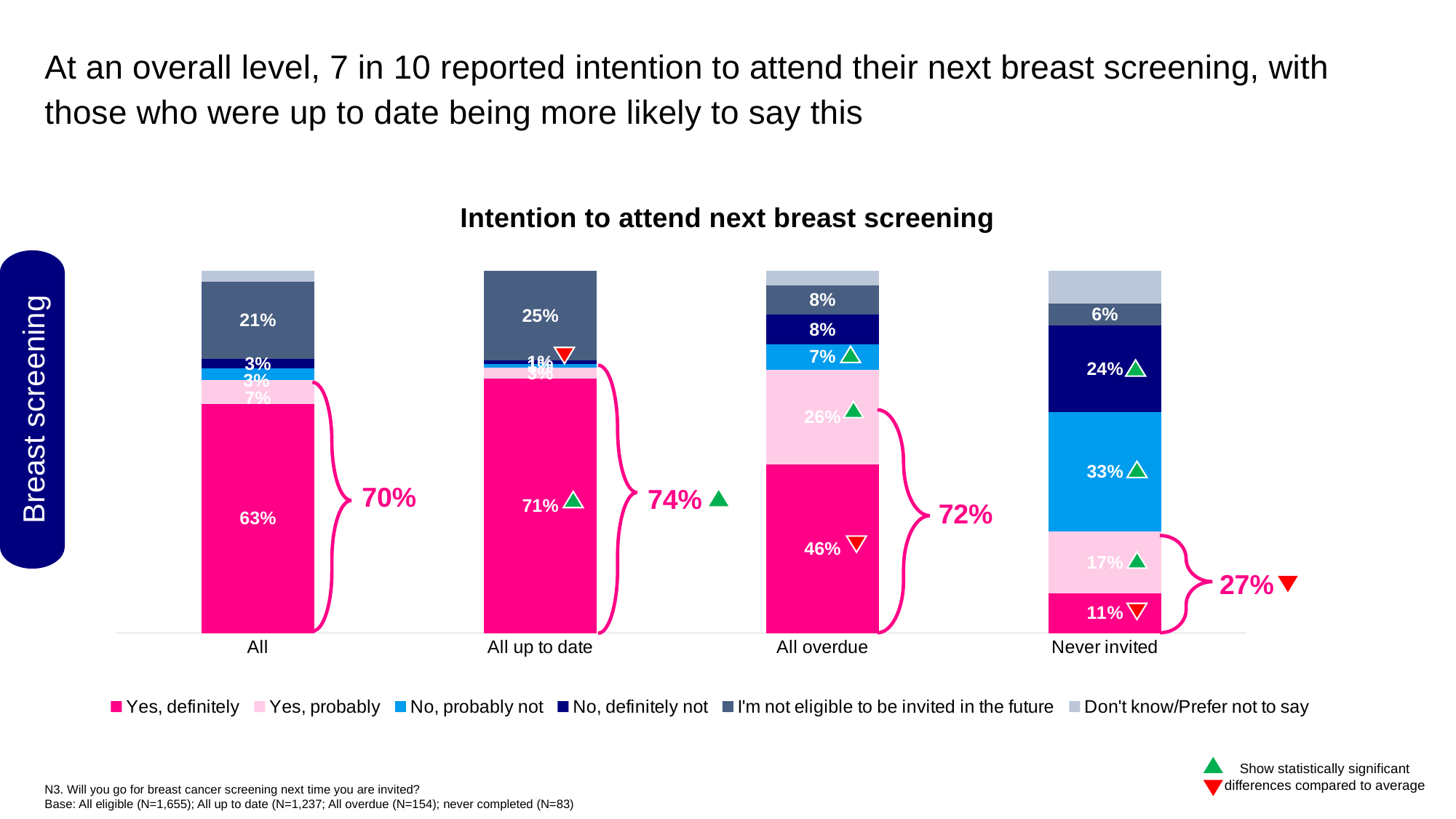
What is the difference between the 'Yes, definitely' values for 'All up to date' and 'All overdue'? 25 percentage points How many series does the legend list? 6 What is the 'I'm not eligible to be invited in the future' value for the 'All up to date' category? 25% Which category has the lowest 'Yes, definitely' value? Never invited What kind of chart is shown on the slide? Stacked bar chart Which category has the highest 'Yes, definitely' value? All up to date How many categories are shown along the x axis of the chart? 4 Which category has the larger 'No, definitely not' value: 'All overdue' or 'Never invited'? Never invited What is the 'Yes, definitely' value for the 'All' category? 63% What combined 'Yes' percentage is shown by the bracket for the 'Never invited' category? 27% What is the 'No, probably not' value for the 'Never invited' category? 33% What is the 'Yes, definitely' value for the 'All overdue' category? 46%